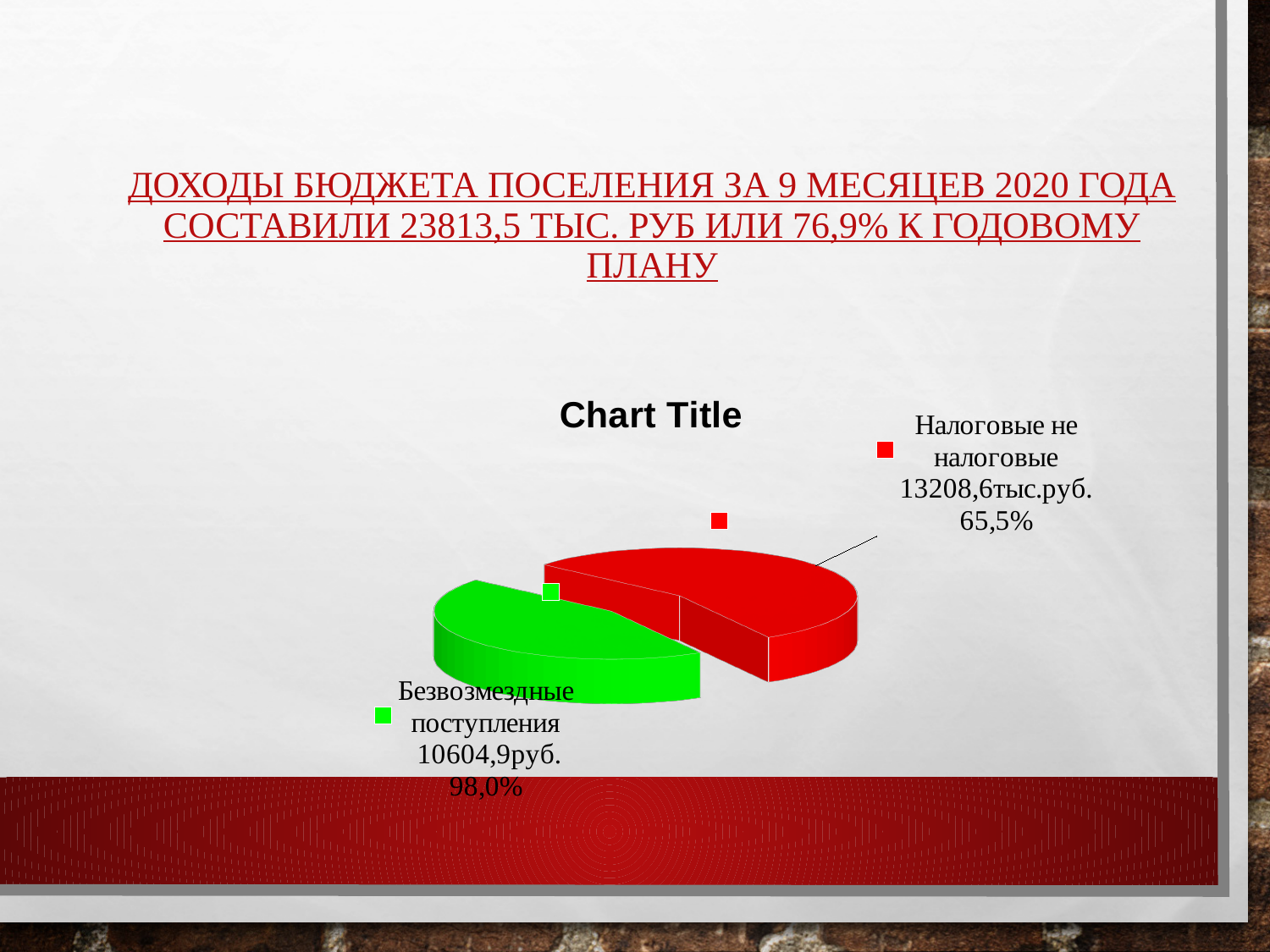
What kind of chart is shown on the slide? pie chart Which slice of the pie chart is the smallest? Безвозмездные поступления Which is larger: 'Налоговые не налоговые' or 'Безвозмездные поступления'? Налоговые не налоговые What is the difference between the 'Налоговые не налоговые' value (13208,6) and the 'Безвозмездные поступления' value (10604,9)? 2603,7 What percentage is shown next to 'Безвозмездные поступления'? 98,0% What value is shown for the 'Налоговые не налоговые' slice? 13208,6тыс.руб. Which slice of the pie chart is the largest? Налоговые не налоговые What colour is the 'Безвозмездные поступления' slice? green What percentage is shown next to 'Налоговые не налоговые'? 65,5% How many slices does the pie chart have? 2 What value is shown for the 'Безвозмездные поступления' slice? 10604,9руб.